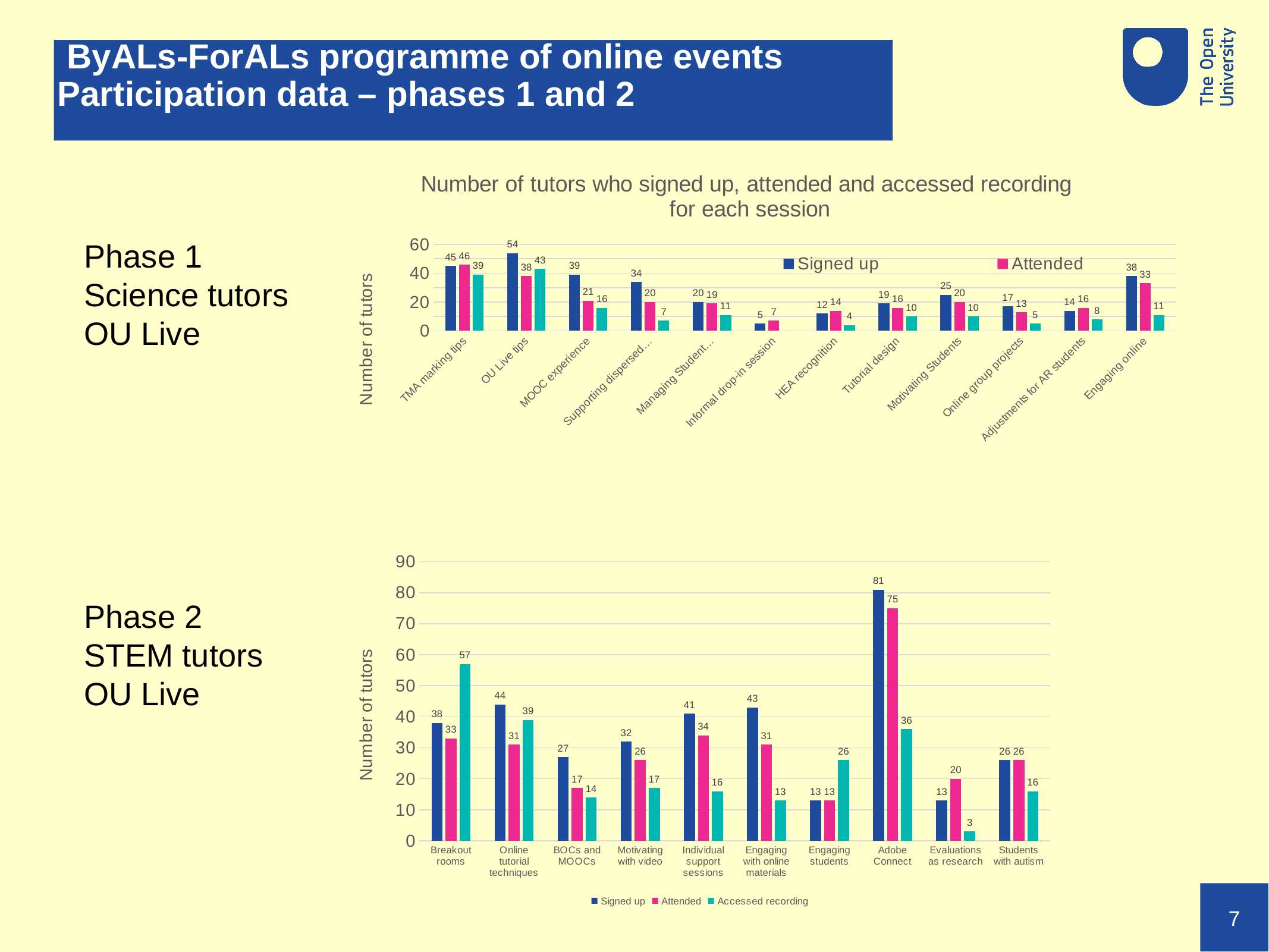
What type of chart is the bottom chart (Phase 2 STEM tutors)? Bar chart In the top chart (Phase 1 Science tutors), how many sessions are shown on the x axis? 12 In the top chart (Phase 1 Science tutors), how many tutors signed up for OU Live tips? 54 In the top chart (Phase 1 Science tutors), how many tutors attended the MOOC experience session? 21 In the bottom chart (Phase 2 STEM tutors), which session had the highest number of tutors signed up? Adobe Connect In the bottom chart (Phase 2 STEM tutors), which session had the lowest number of tutors accessing the recording? Evaluations as research In the bottom chart (Phase 2 STEM tutors), how many tutors signed up for Adobe Connect? 81 In the bottom chart (Phase 2 STEM tutors), how many sessions are shown on the x axis? 10 In the top chart (Phase 1 Science tutors), which is larger for HEA recognition: the number signed up or the number attended? Attended In the bottom chart (Phase 2 STEM tutors), how many tutors accessed the recording for Breakout rooms? 57 How many series does the legend of the bottom chart (Phase 2 STEM tutors) list? 3 In the bottom chart (Phase 2 STEM tutors), what is the difference between the number signed up and the number attended for Adobe Connect? 6